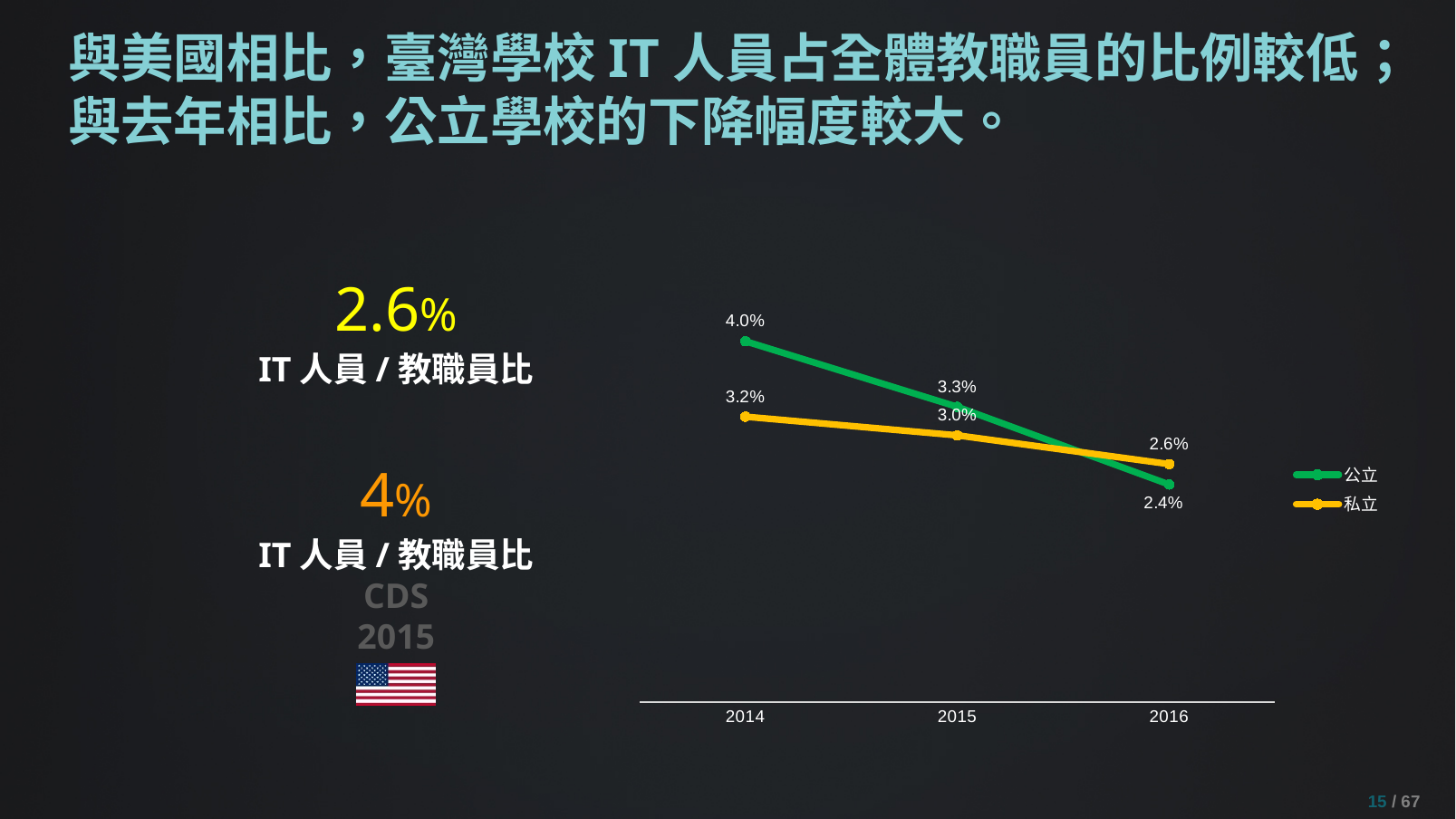
How does the 公立 series change from 2014 to 2016? falls What is the difference between the 公立 and 私立 values in 2014? 0.8% What is the value for 公立 in 2014? 4.0% In which year is the 公立 value lowest? 2016 What is the value for 私立 in 2016? 2.6% What is the value for 私立 in 2014? 3.2% What is the value for 公立 in 2015? 3.3% Which series has the larger value in 2016, 公立 or 私立? 私立 In which year is the 私立 value highest? 2014 What type of chart is shown on the slide? line chart How many years are shown on the x axis of the chart? 3 How many series does the chart legend list? 2